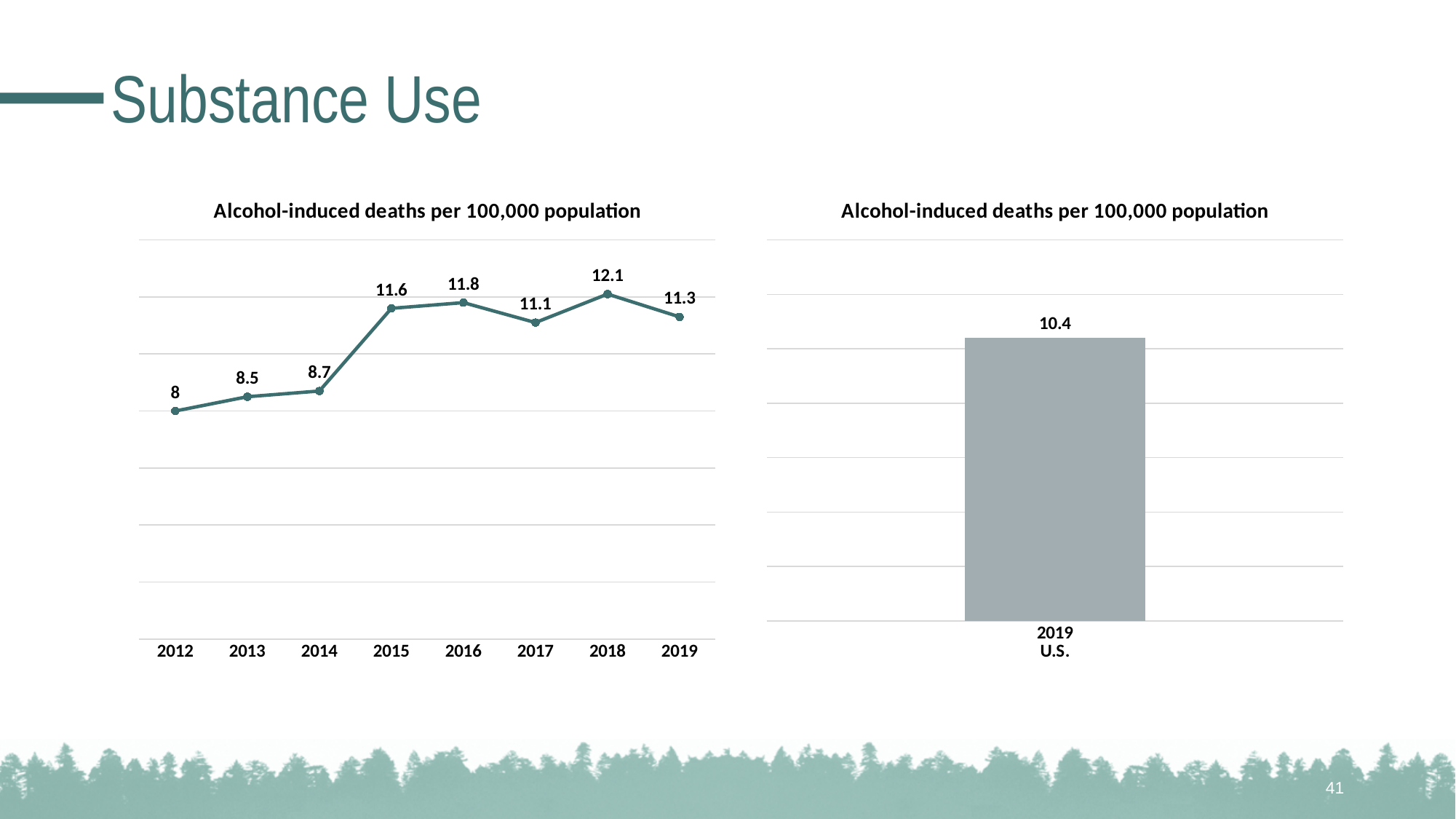
In the left line chart, which year has the highest value? 2018 In the left line chart, what is the difference between the values for 2018 and 2012? 4.1 In the left line chart, what is the value for 2016? 11.8 In the left line chart, do the values generally rise or fall from 2012 to 2019? rise In the left line chart, how many years are plotted? 8 In the right bar chart, what is the value for 2019 U.S.? 10.4 In the left line chart, which is larger, the value for 2015 or the value for 2017? 2015 What is the title of the chart on the right? Alcohol-induced deaths per 100,000 population In the left line chart, what is the value for 2012? 8 In the left line chart, which year has the lowest value? 2012 In the left line chart, what is the value for 2019? 11.3 What kind of chart is the chart on the right? bar chart